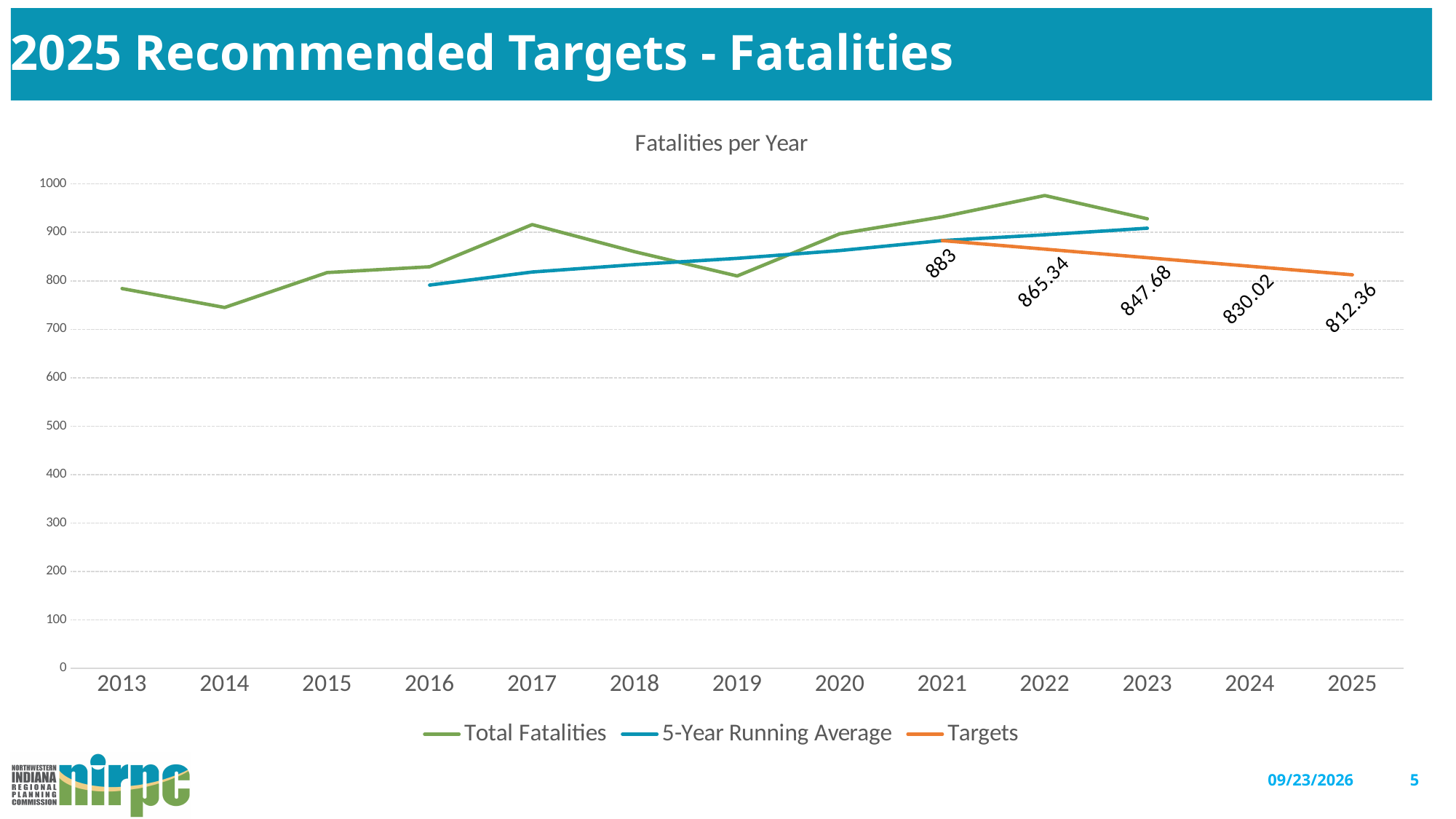
What is the Targets value for 2021? 883 Which is larger, the Targets value for 2022 or for 2024? 2022 (865.34) How many years are shown on the x axis? 13 How many series does the legend list? 3 What is the Targets value for 2025? 812.36 What is the title of the chart? Fatalities per Year What kind of chart is shown on the slide? line chart In which year is Total Fatalities highest? 2022 What is the difference between the Targets value for 2021 and the Targets value for 2025? 70.64 Do the Targets values rise or fall from 2021 to 2025? fall What is the Targets value for 2023? 847.68 Is the Total Fatalities value for 2014 greater or less than 800? less